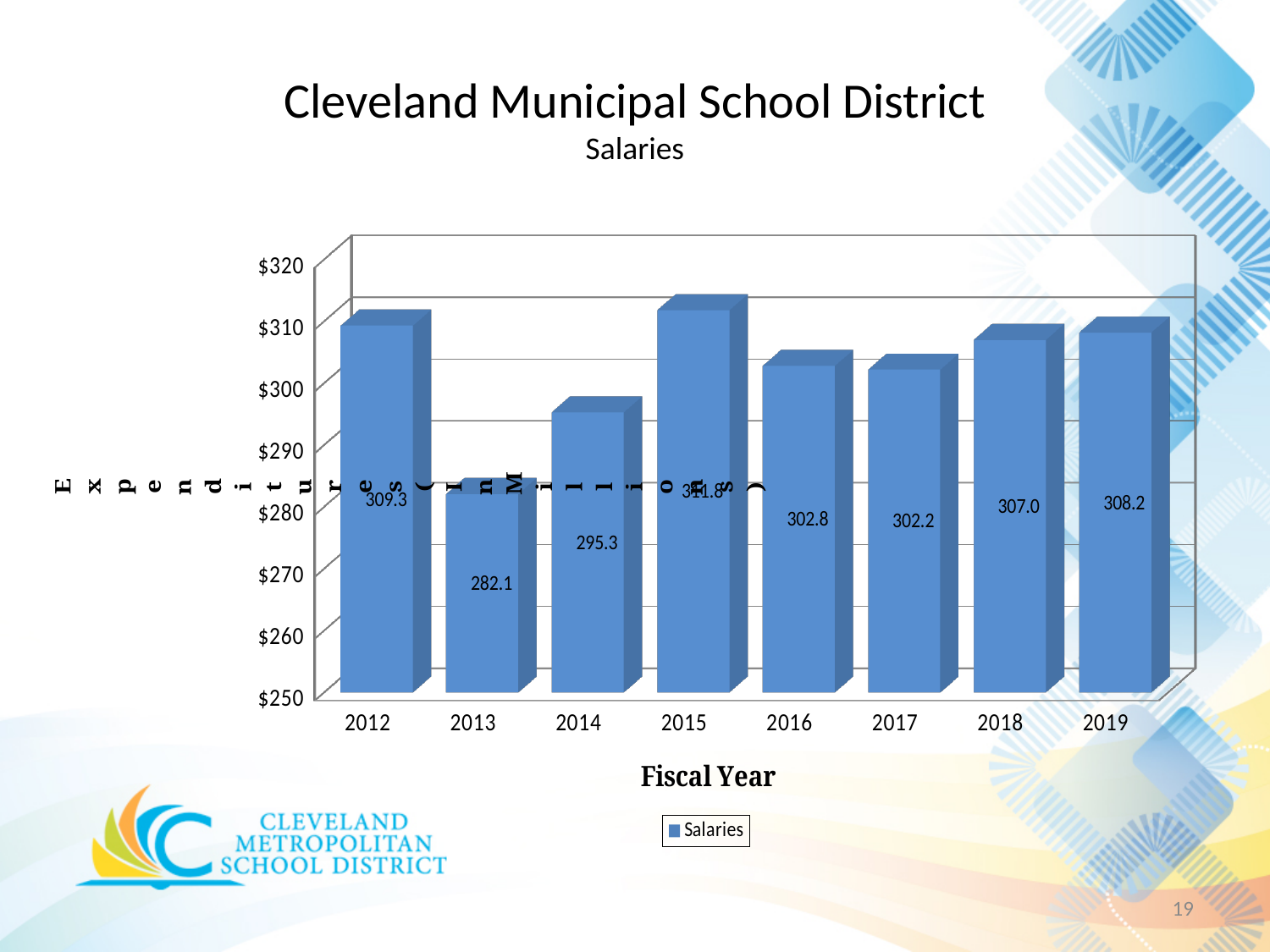
Which fiscal year has the highest salaries value? 2015 Which fiscal year has the lowest salaries value? 2013 What is the value for 2012? 309.3 What is the difference between the values for 2014 and 2013? 13.2 What is the value for 2018? 307.0 What kind of chart is shown on the slide? bar chart What is the x-axis title of the chart? Fiscal Year What is the value for 2013? 282.1 What is the value for 2019? 308.2 Which is larger, the value for 2016 or the value for 2017? 2016 How many fiscal years are shown on the x axis? 8 Is the value for 2014 greater or less than $300? less